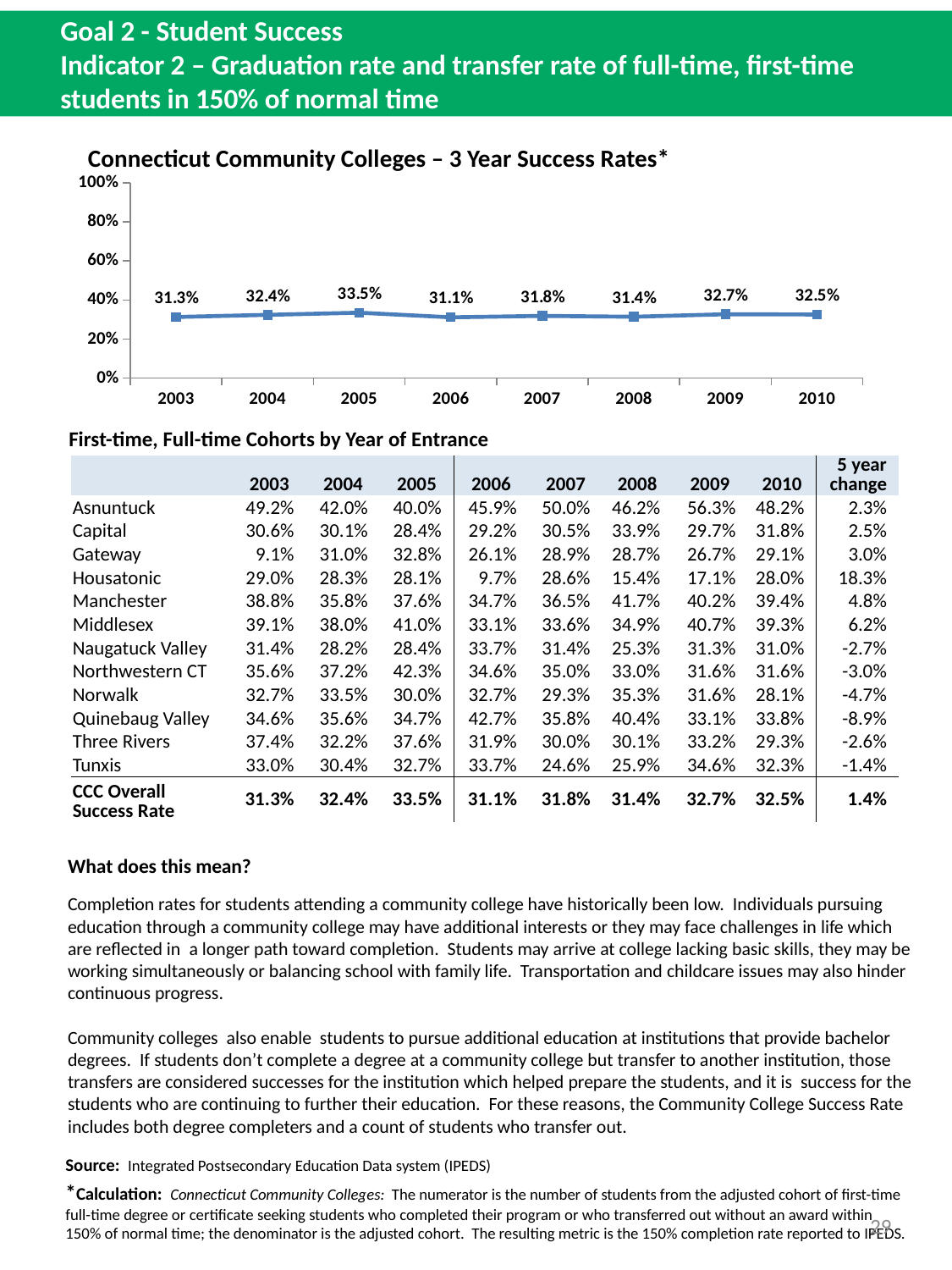
Which is larger on the chart, the success rate for 2004 or for 2008? 2004 What is the title of the chart? Connecticut Community Colleges – 3 Year Success Rates* What is the difference between the 2005 and 2006 success rates on the chart? 2.4% Is the value for 2007 on the chart greater or less than 40%? less Which year has the highest 3 year success rate on the chart? 2005 What kind of chart is shown on the slide? line chart What is the 3 year success rate shown for 2005? 33.5% How many years are plotted on the chart? 8 Which year has the lowest 3 year success rate on the chart? 2006 What is the 3 year success rate shown for 2010? 32.5% What is the maximum value shown on the chart's y axis? 100% What is the 3 year success rate shown for 2003? 31.3%